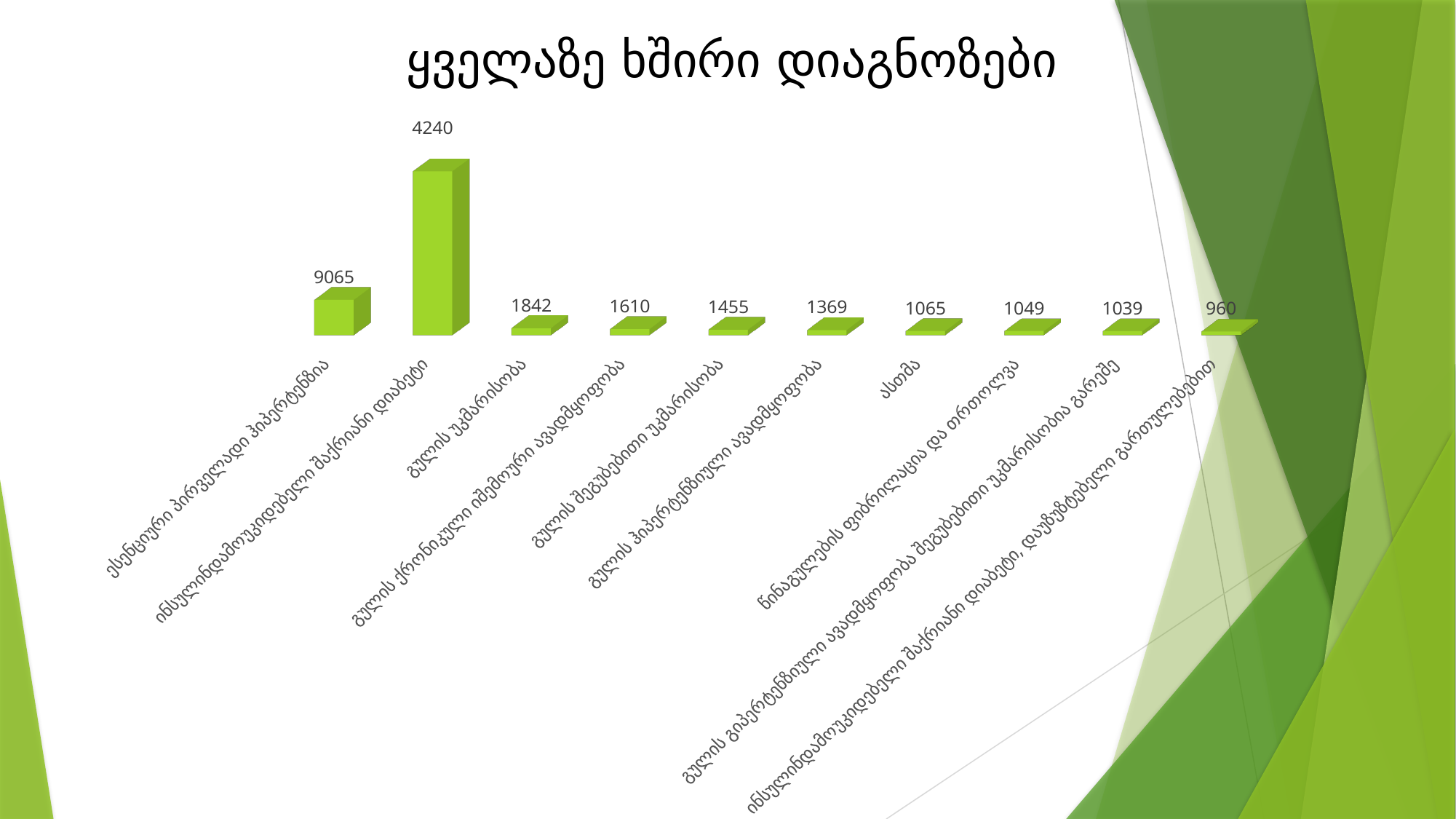
How many categories are shown in the chart? 10 What is the value for წინაგულების ფიბრილაცია და თრთოლვა? 1049 What kind of chart is shown on the slide? Bar chart Which is larger, the value for გულის შეგუბებითი უკმარისობა or the value for გულის ჰიპერტენზიული ავადმყოფობა? გულის შეგუბებითი უკმარისობა What is the difference between the values for ინსულინდამოუკიდებელი შაქრიანი დიაბეტი and გულის უკმარისობა? 2398 What is the difference between the values for ასთმა and წინაგულების ფიბრილაცია და თრთოლვა? 16 What is the title of the chart? ყველაზე ხშირი დიაგნოზები What is the value for ასთმა? 1065 What is the value for გულის ქრონიკული იშემიური ავადმყოფობა? 1610 Which category has the lowest value? ინსულინდამოუკიდებელი შაქრიანი დიაბეტი, დაუზუზტებელი გართულებებით What is the value for ინსულინდამოუკიდებელი შაქრიანი დიაბეტი? 4240 What is the value for გულის უკმარისობა? 1842